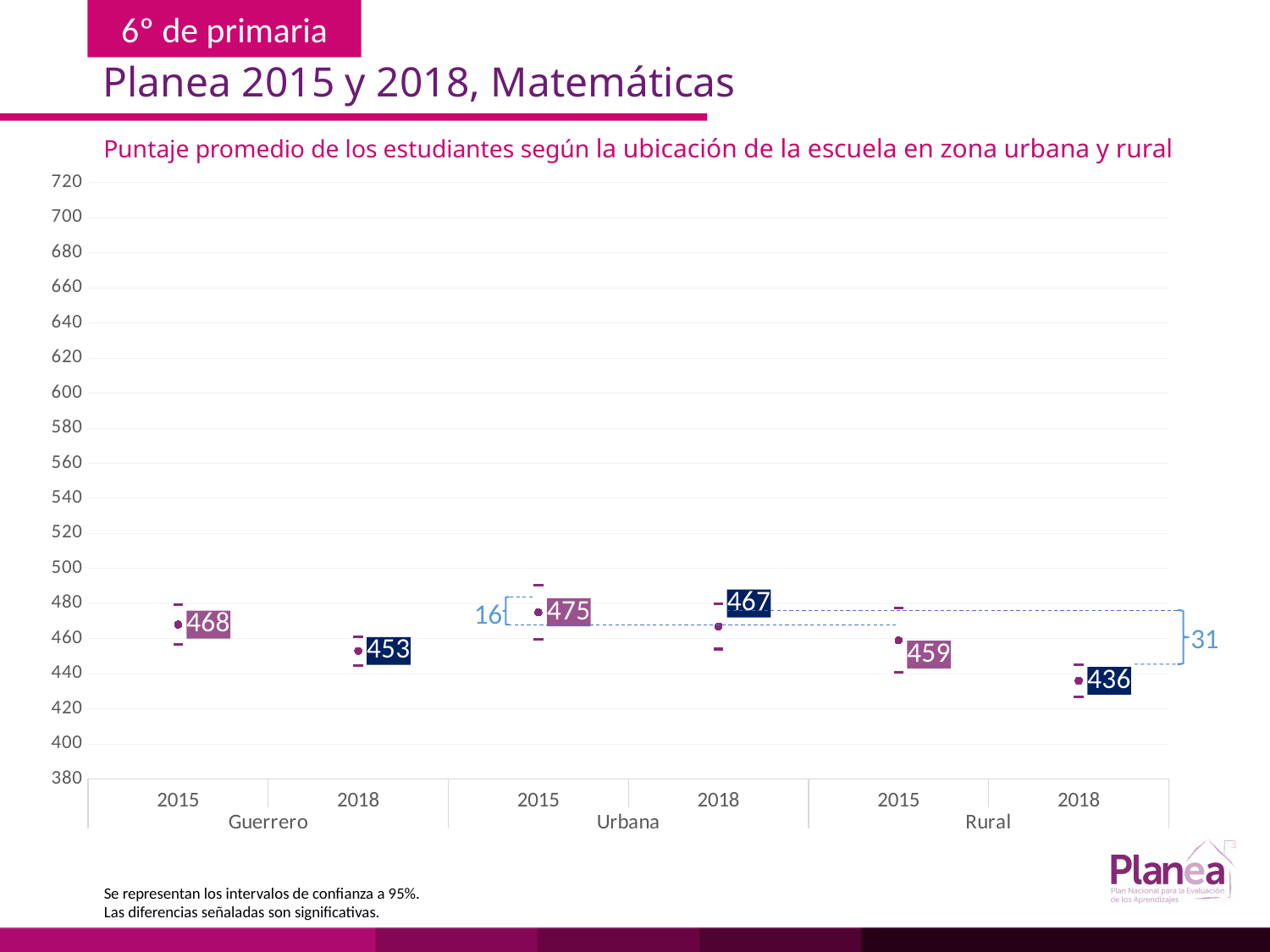
What is the average score for Guerrero in 2018? 453 Did the average score for Rural schools rise or fall from 2015 to 2018? Fall Which group and year has the highest average score? Urbana 2015 What is the average score for Guerrero in 2015? 468 How many data points are plotted on the chart? 6 Which group and year has the lowest average score? Rural 2018 What is the difference between the Urbana and Rural average scores in 2015? 16 Which is larger, the Guerrero 2015 score or the Rural 2015 score? Guerrero 2015 What is the average score for Urbana schools in 2015? 475 What is the average score for Rural schools in 2018? 436 What is the difference between the Urbana and Rural average scores in 2018? 31 What is the title of the chart? Puntaje promedio de los estudiantes según la ubicación de la escuela en zona urbana y rural